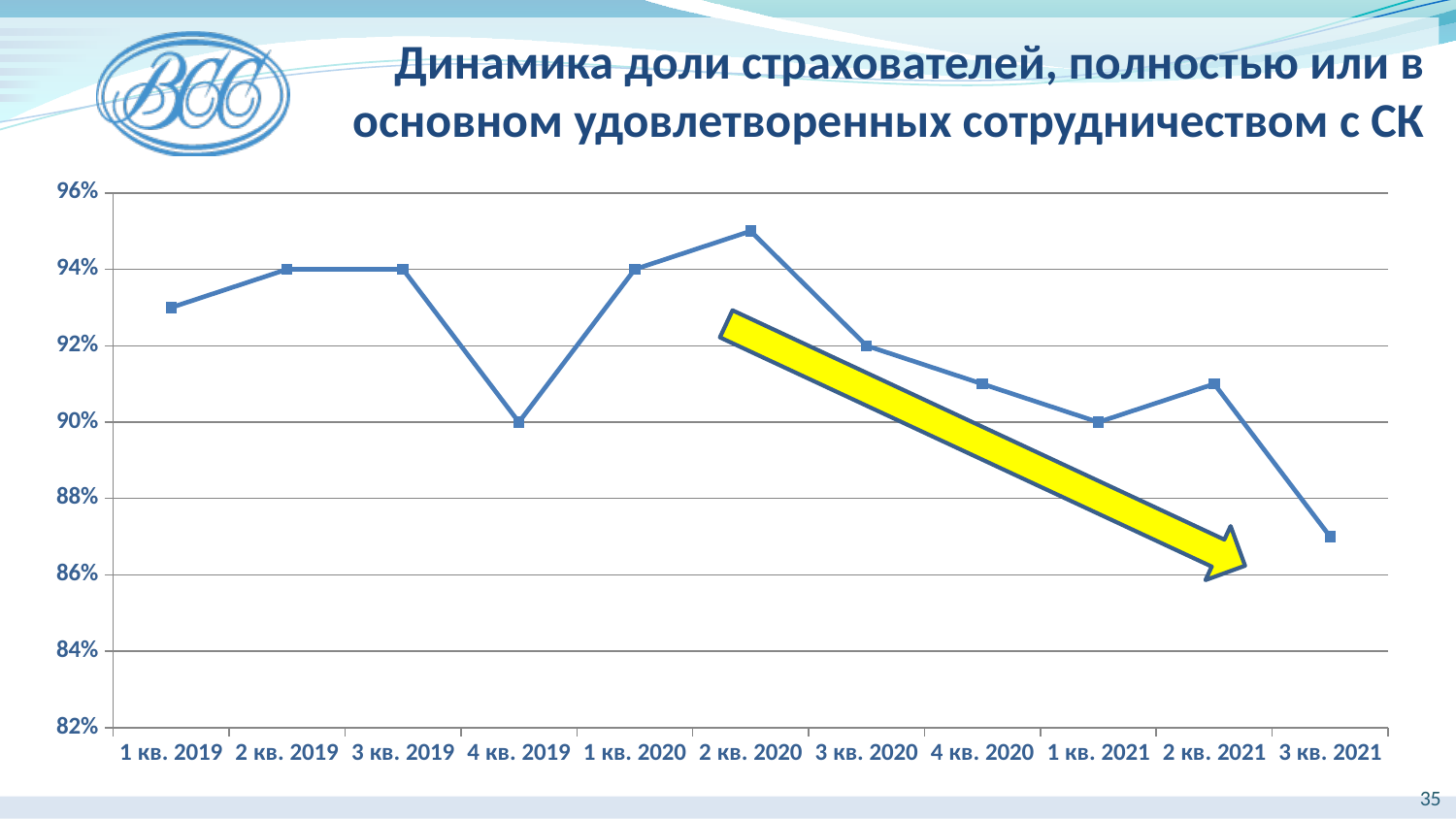
Is the value for 3 кв. 2021 greater or less than 88%? less Which is larger, the value for 1 кв. 2019 or the value for 4 кв. 2019? 1 кв. 2019 How many quarters (data points) are plotted on the chart? 11 Is the value for 2 кв. 2020 greater or less than 94%? greater What is the value for 4 кв. 2019? 90% Overall, do the values rise or fall from 1 кв. 2019 to 3 кв. 2021? Fall What is the value for 3 кв. 2020? 92% What is the lowest value shown on the vertical axis? 82% Which quarter has the highest share of satisfied policyholders? 2 кв. 2020 What is the value for 2 кв. 2019? 94% What kind of chart is shown on the slide? Line chart Which quarter has the lowest share of satisfied policyholders? 3 кв. 2021